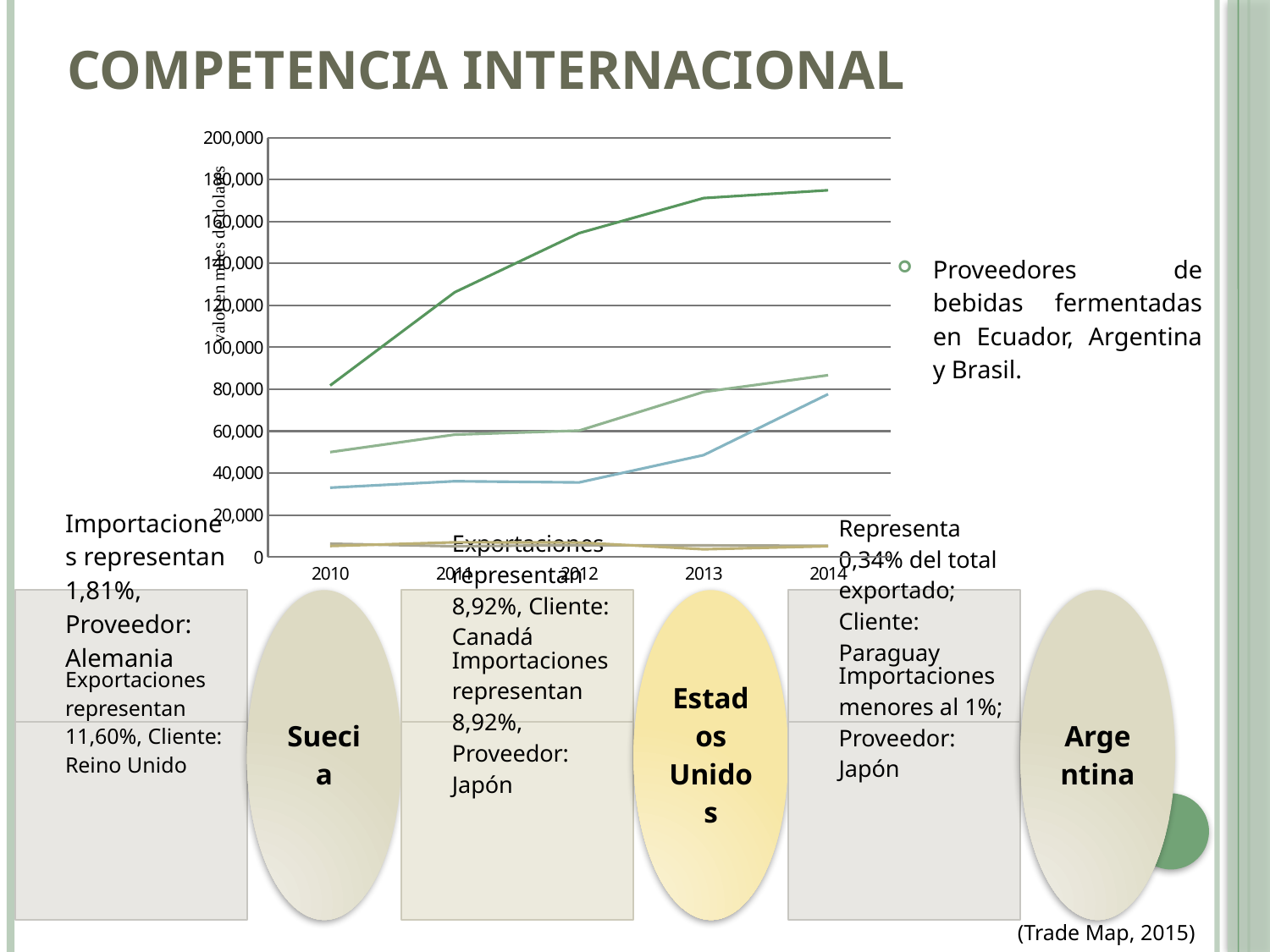
In 2014, which line is higher: the dark green line or the blue line? dark green line Is the value of the lowest (yellow) line in 2012 greater or less than 20,000? less What is the highest value shown on the y axis of the chart? 200,000 How many years are shown along the x axis of the chart? 5 Is the value of the light green line in 2010 greater or less than 40,000? greater Is the value of the blue line in 2014 greater or less than 60,000? greater What kind of chart is shown on the slide? line chart Does the blue line rise or fall between 2012 and 2014? rise Does the dark green line rise or fall from 2010 to 2014? rise